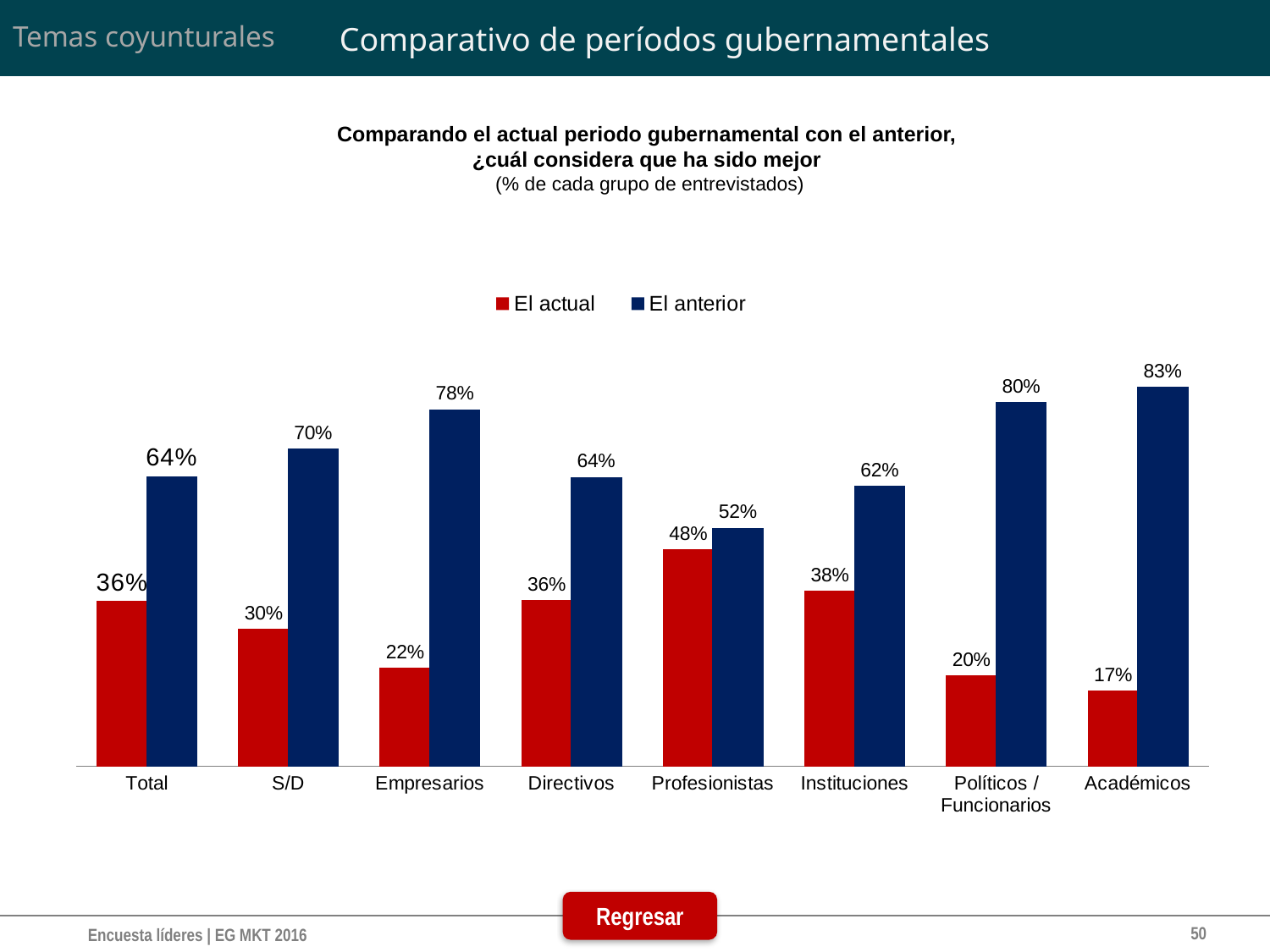
What is the difference between 'El anterior' and 'El actual' for Total? 28% What is the value of 'El actual' for Empresarios? 22% Which category has the lowest value for 'El actual'? Académicos Which category has the highest value for 'El anterior'? Académicos What is the value of 'El actual' for Profesionistas? 48% What is the value of 'El anterior' for Políticos / Funcionarios? 80% What kind of chart is shown on the slide? Bar chart How many categories are shown on the x axis? 8 How many series does the legend list? 2 Which colour represents 'El anterior' in the chart? Dark blue Which is larger for Profesionistas: 'El actual' or 'El anterior'? El anterior What is the difference between 'El anterior' and 'El actual' for Académicos? 66%